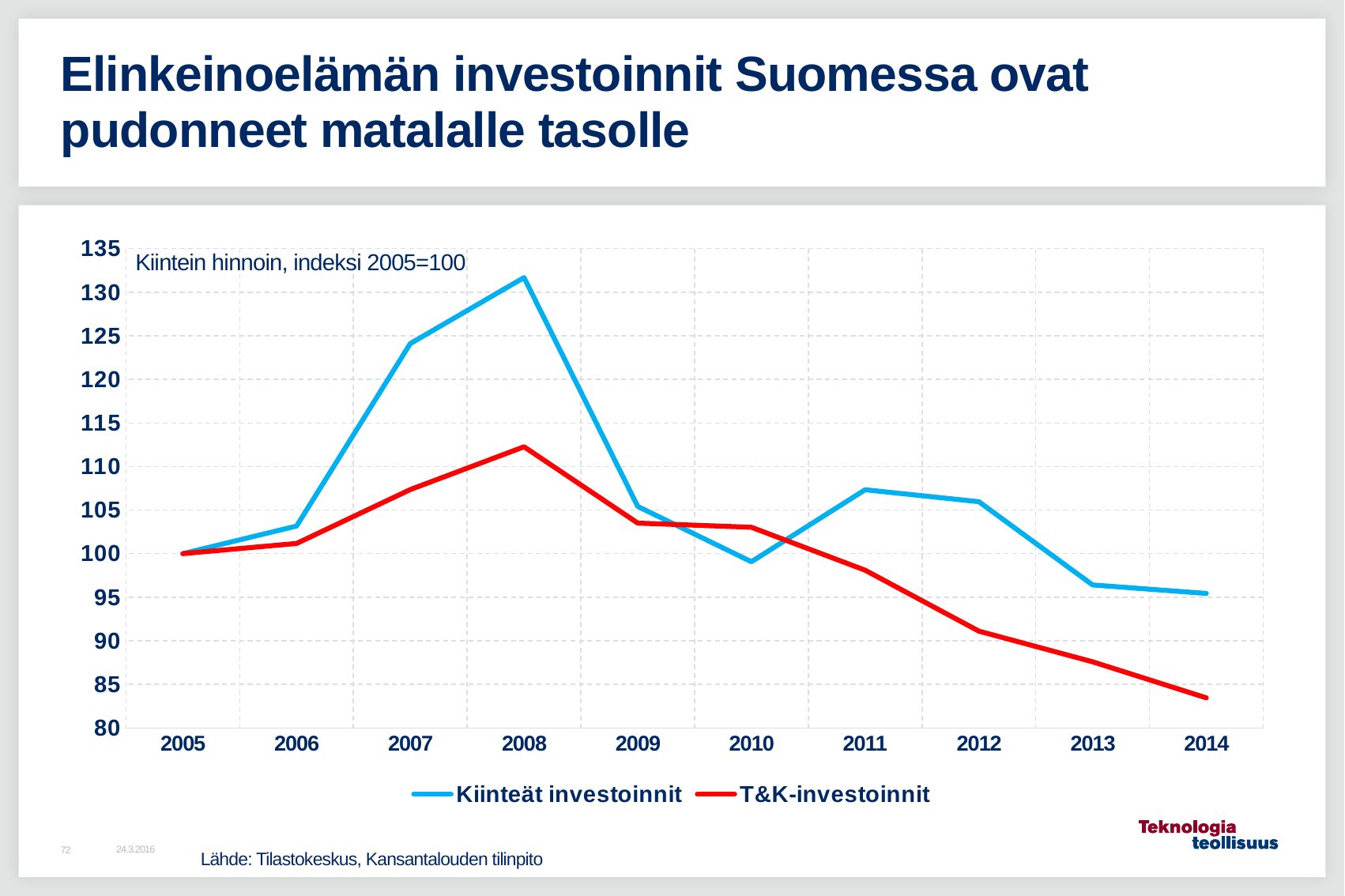
In which year does Kiinteät investoinnit reach its highest value? 2008 Does T&K-investoinnit rise or fall from 2008 to 2014? fall Is the value for Kiinteät investoinnit in 2008 greater or less than 130? greater In 2010, which series has the higher value, Kiinteät investoinnit or T&K-investoinnit? T&K-investoinnit How many years are shown on the x axis? 10 How many series does the legend list? 2 What is the value of Kiinteät investoinnit in 2005? 100 Is the value for T&K-investoinnit in 2014 greater or less than 85? less In which year is T&K-investoinnit at its lowest? 2014 In which year does T&K-investoinnit reach its highest value? 2008 What kind of chart is shown on the slide? line chart What is the value of T&K-investoinnit in 2005? 100